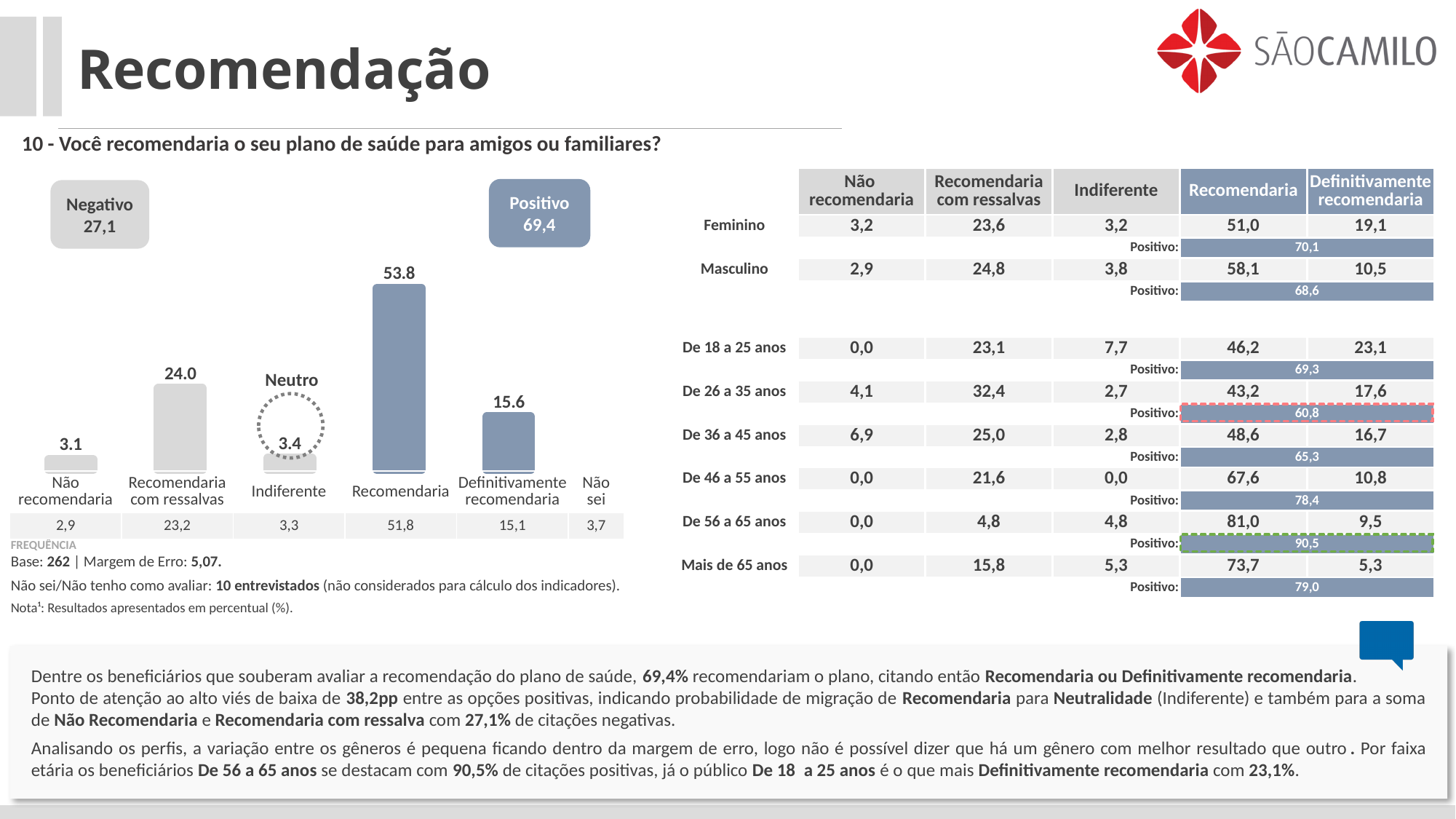
Which category has the lowest value in the bar chart? Não recomendaria In the bar chart, what is the value for Não recomendaria? 3.1 In the bar chart, what is the value for Recomendaria com ressalvas? 24.0 What value is shown in the 'Positivo' box above the bar chart? 69,4 Which category has the highest value in the bar chart? Recomendaria In the bar chart, which is larger: Recomendaria com ressalvas or Definitivamente recomendaria? Recomendaria com ressalvas In the bar chart, what is the value for Indiferente? 3.4 In the bar chart, what is the difference between the values for Recomendaria and Definitivamente recomendaria? 38.2 In the bar chart, what is the value for Recomendaria? 53.8 How many bars are plotted in the bar chart? 5 In the bar chart, what is the value for Definitivamente recomendaria? 15.6 What type of chart is shown on the left of the slide? bar chart